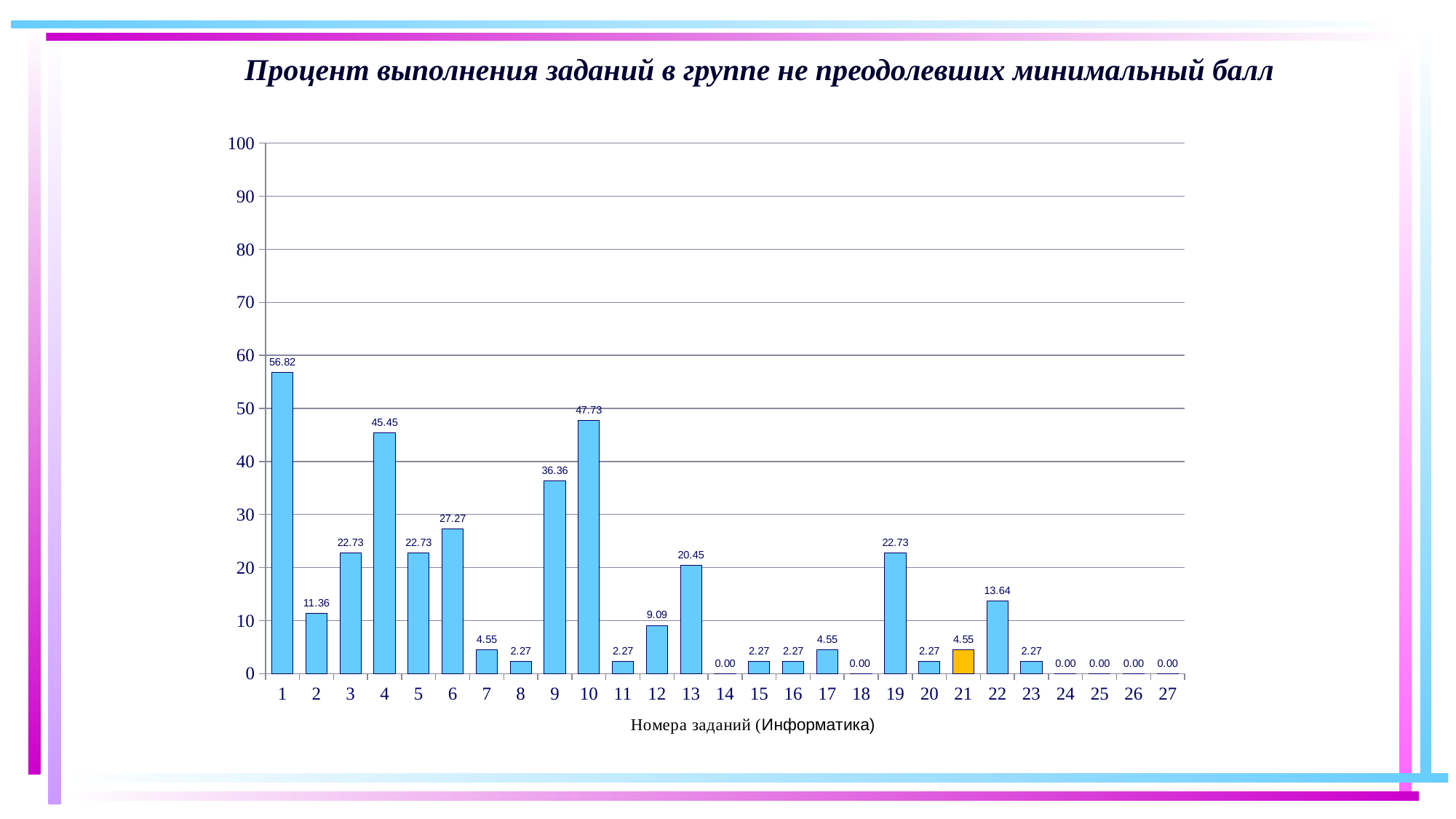
What is the value for task 10? 47.73 Is the value for task 9 greater or less than 30? greater Which task number has a bar coloured differently (orange) from the others? 21 How many task numbers are shown on the x axis? 27 What is the value for task 1? 56.82 What is the value for task 22? 13.64 What kind of chart is shown on the slide? bar chart Which is larger, the value for task 6 or the value for task 19? task 6 Which task number has the highest value? 1 What is the value for task 13? 20.45 What is the difference between the values for task 1 and task 4? 11.37 What is the difference between the values for task 10 and task 9? 11.37